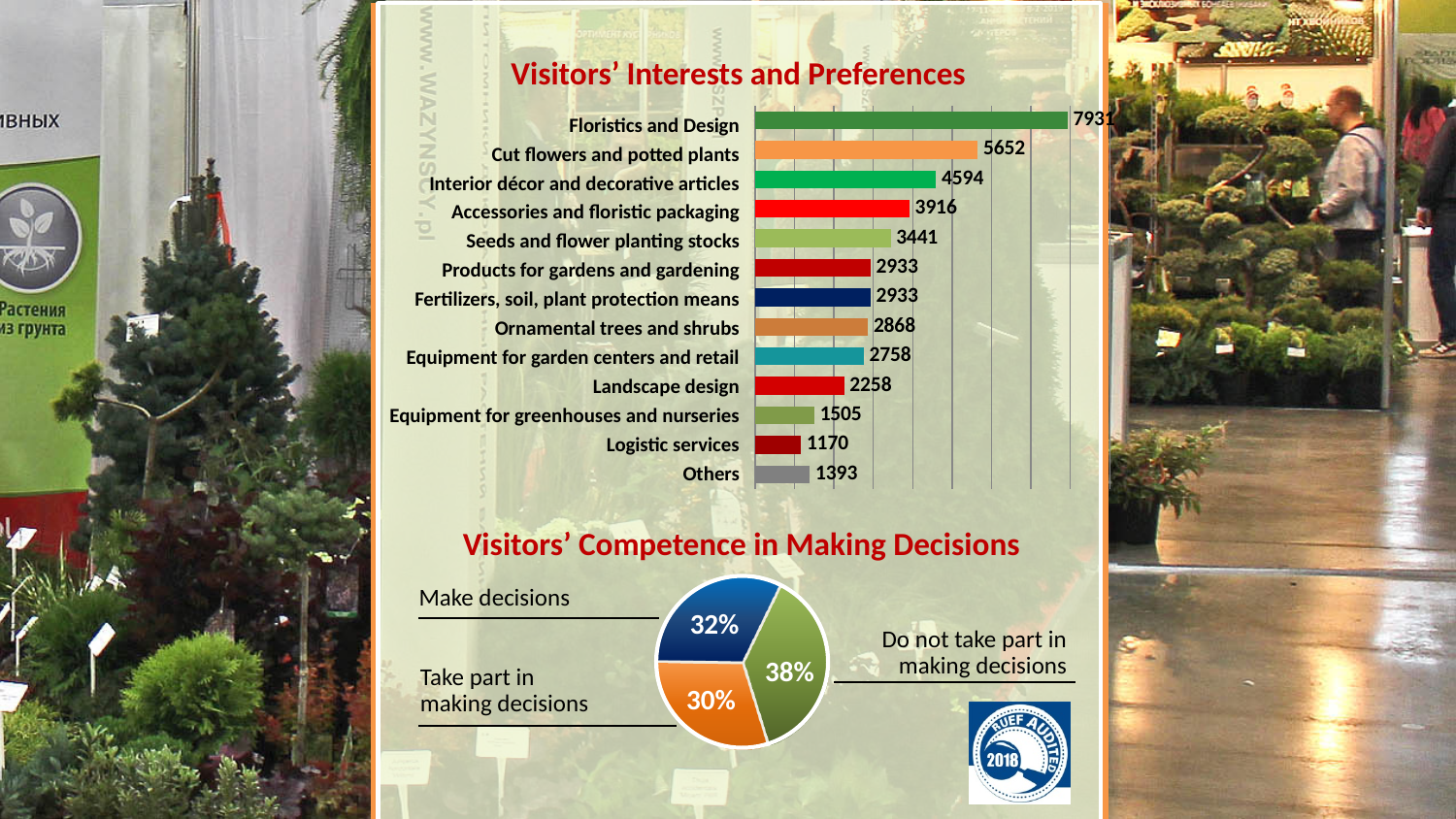
What kind of chart is 'Visitors' Interests and Preferences'? Bar chart In the 'Visitors' Competence in Making Decisions' chart, what share of visitors make decisions? 32% How many categories are shown in the 'Visitors' Interests and Preferences' chart? 13 In the 'Visitors' Competence in Making Decisions' chart, which slice is the smallest? Take part in making decisions In the 'Visitors' Interests and Preferences' chart, what is the difference between Cut flowers and potted plants and Interior décor and decorative articles? 1058 In the 'Visitors' Interests and Preferences' chart, which category has the highest value? Floristics and Design In the 'Visitors' Interests and Preferences' chart, what is the value for Floristics and Design? 7931 In the 'Visitors' Interests and Preferences' chart, which is larger: Landscape design or Equipment for greenhouses and nurseries? Landscape design What kind of chart is 'Visitors' Competence in Making Decisions'? Pie chart In the 'Visitors' Interests and Preferences' chart, what is the value for Seeds and flower planting stocks? 3441 In the 'Visitors' Competence in Making Decisions' chart, what share of visitors do not take part in making decisions? 38% In the 'Visitors' Interests and Preferences' chart, which category has the lowest value? Logistic services